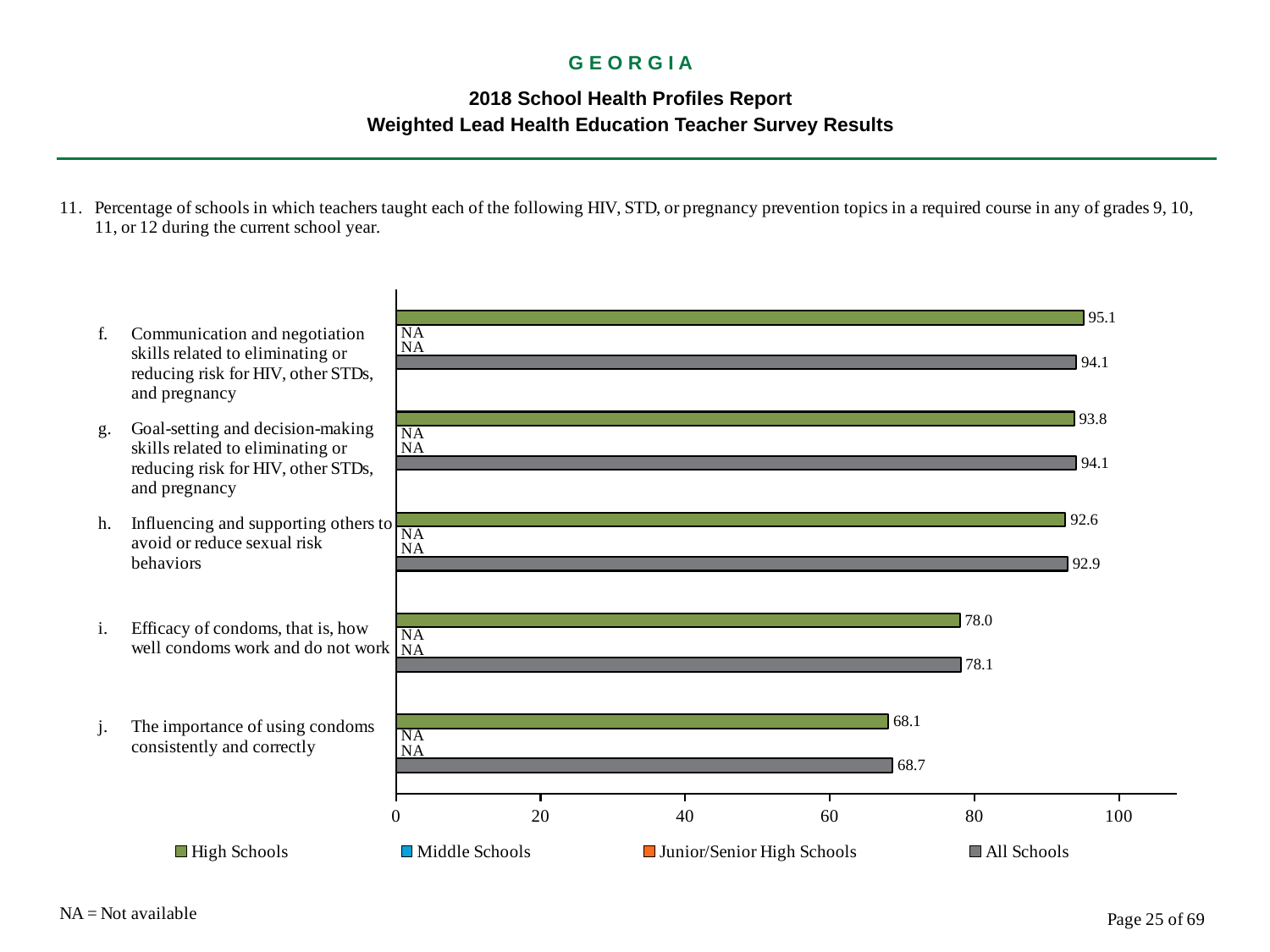
What kind of chart is shown on the slide? bar chart Which topic has the highest High Schools value? f. Communication and negotiation skills related to eliminating or reducing risk for HIV, other STDs, and pregnancy What is the High Schools value for topic f, communication and negotiation skills related to eliminating or reducing risk for HIV, other STDs, and pregnancy? 95.1 What is the difference between the High Schools value for topic f and the High Schools value for topic j? 27.0 Which topic has the lowest All Schools value? j. The importance of using condoms consistently and correctly How many series does the legend list? 4 Is the High Schools value for topic j, the importance of using condoms consistently and correctly, greater or less than 80? less How many topics are shown on the chart? 5 What is the All Schools value for topic j, the importance of using condoms consistently and correctly? 68.7 What is the All Schools value for topic h, influencing and supporting others to avoid or reduce sexual risk behaviors? 92.9 For topic i, efficacy of condoms, which is larger: the High Schools value or the All Schools value? All Schools What is the difference between the All Schools value and the High Schools value for topic g, goal-setting and decision-making skills? 0.3